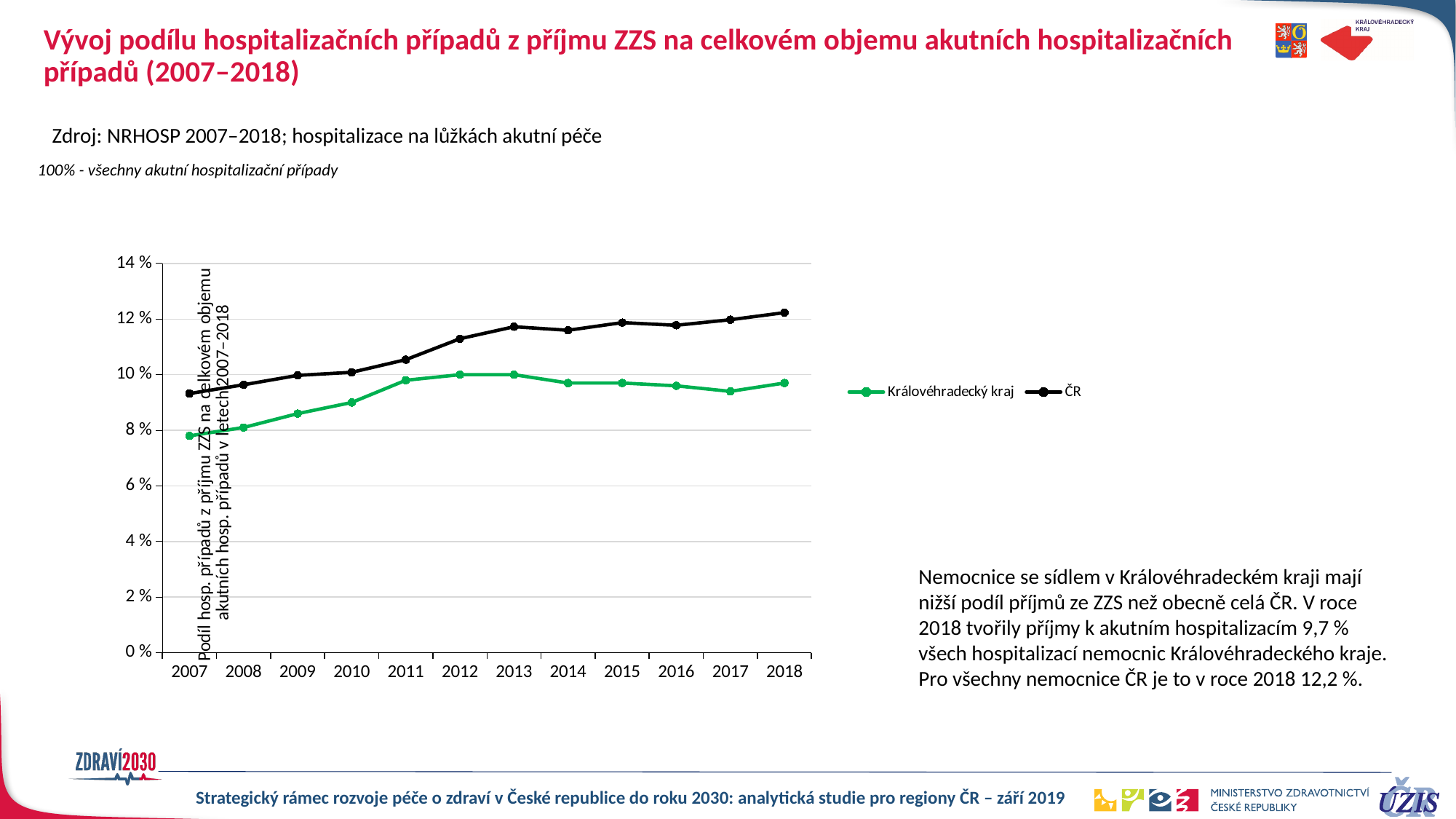
How many series does the legend list? 2 Is the value for ČR in 2007 greater or less than 10 %? less What kind of chart is shown on the slide? line chart Does the ČR series generally rise or fall from 2007 to 2018? rise How many years are plotted along the x axis? 12 In which year is the Královéhradecký kraj series at its lowest? 2007 Is the value for Královéhradecký kraj in 2007 greater or less than 6 %? greater According to the slide, what was the share for Královéhradecký kraj in 2018? 9,7 % In 2018, which series has the higher value, ČR or Královéhradecký kraj? ČR According to the slide, what was the share for ČR in 2018? 12,2 % What colour is the line for ČR? black What is the difference between the ČR value and the Královéhradecký kraj value in 2018? 2,5 %